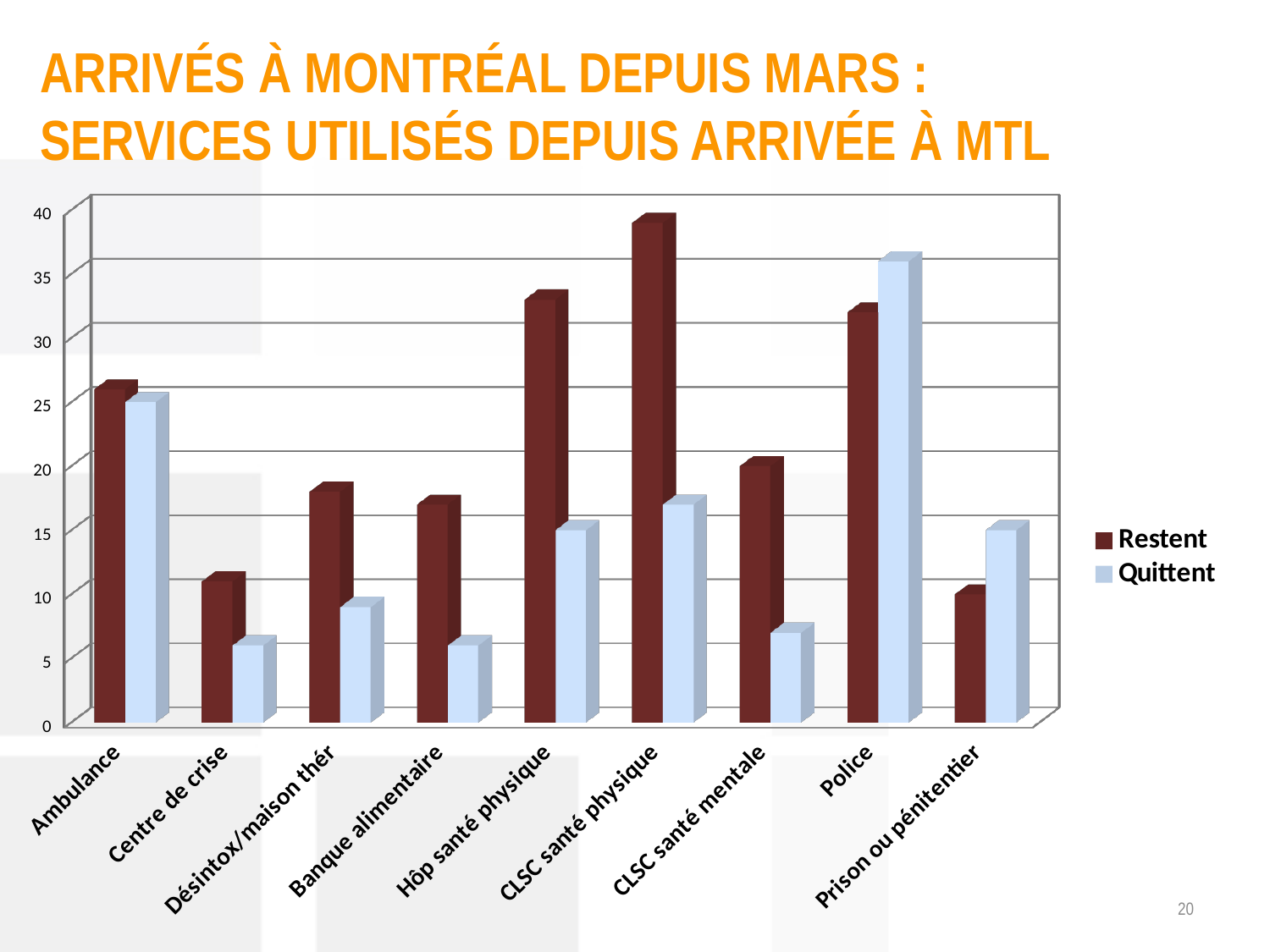
How many service categories are shown on the x axis? 9 How many series does the legend list? 2 What are the two series named in the legend? Restent and Quittent Is the Quittent value for Centre de crise greater or less than 10? less For Police, which series has the larger value, Restent or Quittent? Quittent Which category has the highest value for the Quittent series? Police Which category has the highest value for the Restent series? CLSC santé physique Is the Quittent value for Prison ou pénitentier greater or less than 10? greater For CLSC santé physique, which series has the larger value, Restent or Quittent? Restent Is the Restent value for Ambulance greater or less than 20? greater What kind of chart is shown on the slide? Bar chart